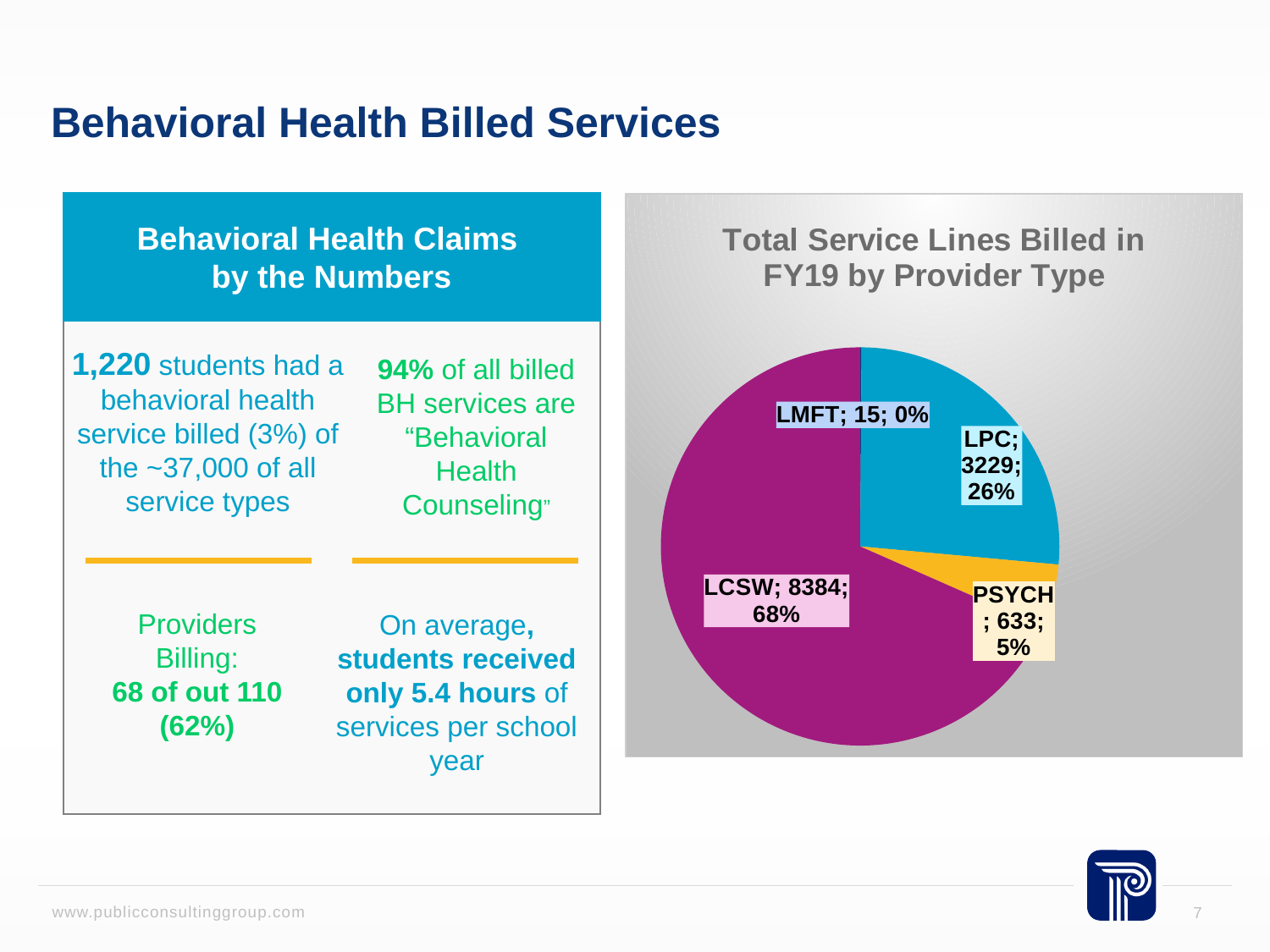
What share of the pie does LCSW represent? 68% How many service lines were billed by LMFT providers? 15 What is the difference in service lines billed between LCSW and LPC? 5155 What type of chart is shown on the slide? pie chart What is the title of the chart? Total Service Lines Billed in FY19 by Provider Type How many provider types are shown in the pie chart? 4 How many service lines were billed by PSYCH providers? 633 Which provider type has the highest number of service lines billed? LCSW How many service lines were billed by LCSW providers? 8384 How many service lines were billed by LPC providers? 3229 What share of the pie does LPC represent? 26% Which provider type has the lowest number of service lines billed? LMFT